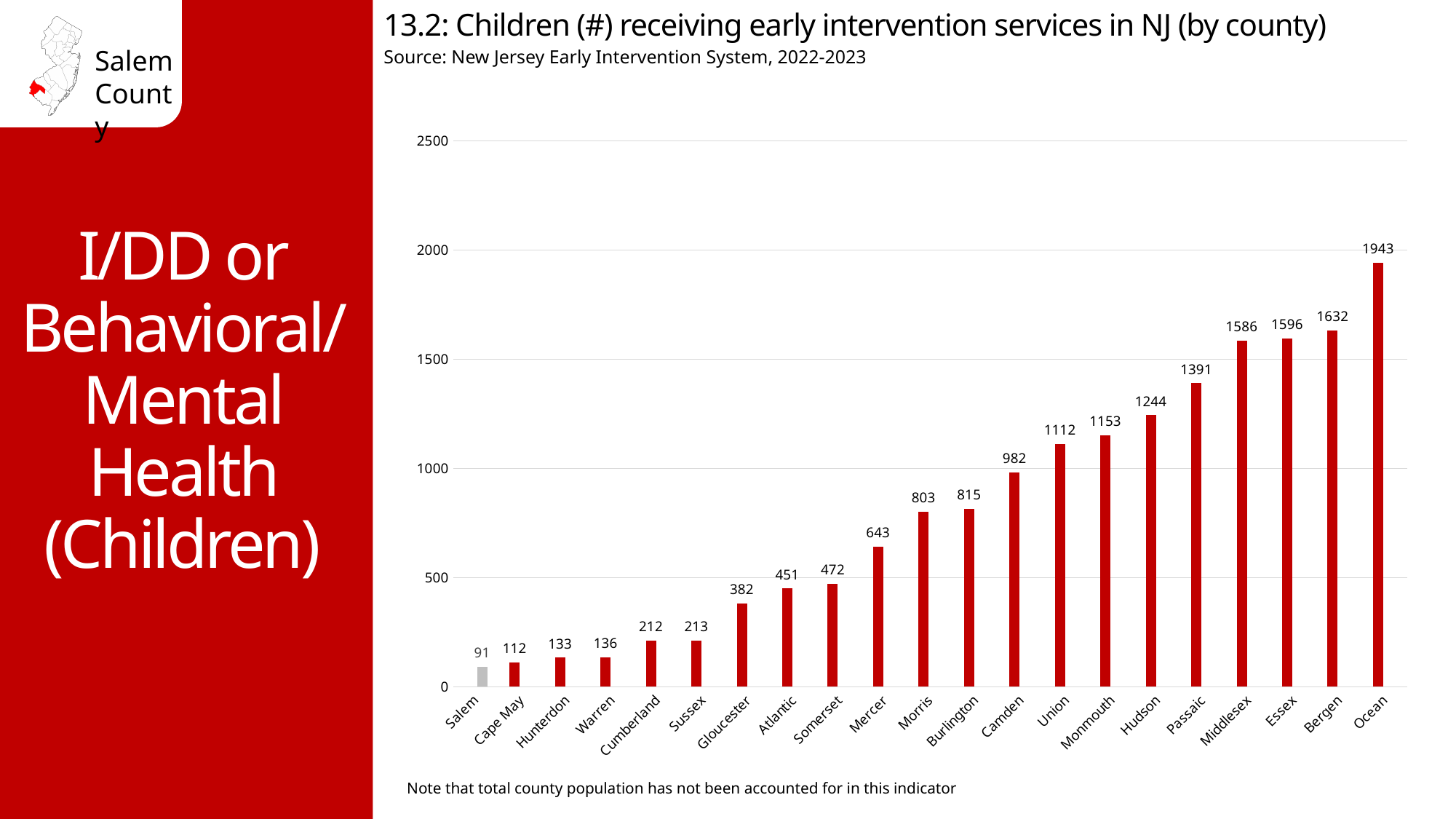
How many counties are shown on the chart? 21 What is the difference between the values for Ocean and Salem? 1852 What is the value shown for Camden? 982 Which has a larger value, Mercer or Morris? Morris What is the value shown for Gloucester? 382 What kind of chart is shown on the slide? Bar chart Do the values rise or fall moving from left to right along the x axis? Rise What is the difference between the values for Bergen and Essex? 36 Is the value for Hudson greater or less than 1000? greater How many children in Salem County are receiving early intervention services? 91 Which county has the highest number of children receiving early intervention services? Ocean Which county has the lowest number of children receiving early intervention services? Salem